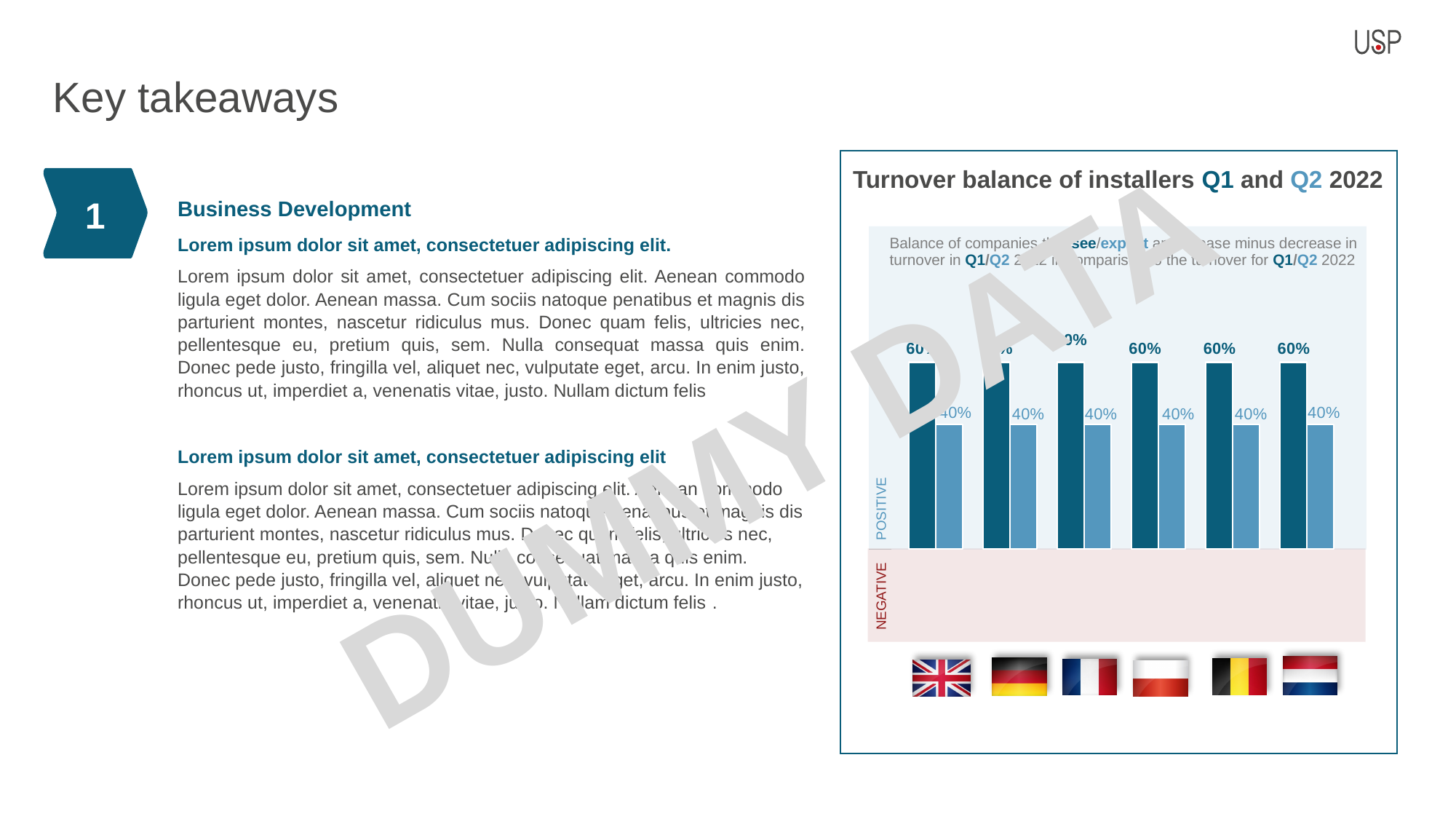
How many series does the chart show? 2 What is the title of the chart? Turnover balance of installers Q1 and Q2 2022 What is the Q1 2022 value for Poland (the fourth flag)? 60% Are all the plotted bars in the positive or the negative region of the chart? positive Is the Q2 value for Germany (the second flag) greater or less than 60%? less What kind of chart is shown on the slide? bar chart What is the Q2 2022 value for the Netherlands (the last flag)? 40% Do the Q1 values rise, fall or stay flat across the countries? stay flat How many countries (flags) are shown along the x axis of the chart? 6 What is the Q1 2022 value for Belgium (the fifth flag)? 60% What is the difference between the Q1 and Q2 values for Belgium? 20 percentage points For France (the third flag), which is larger: the Q1 value or the Q2 value? Q1